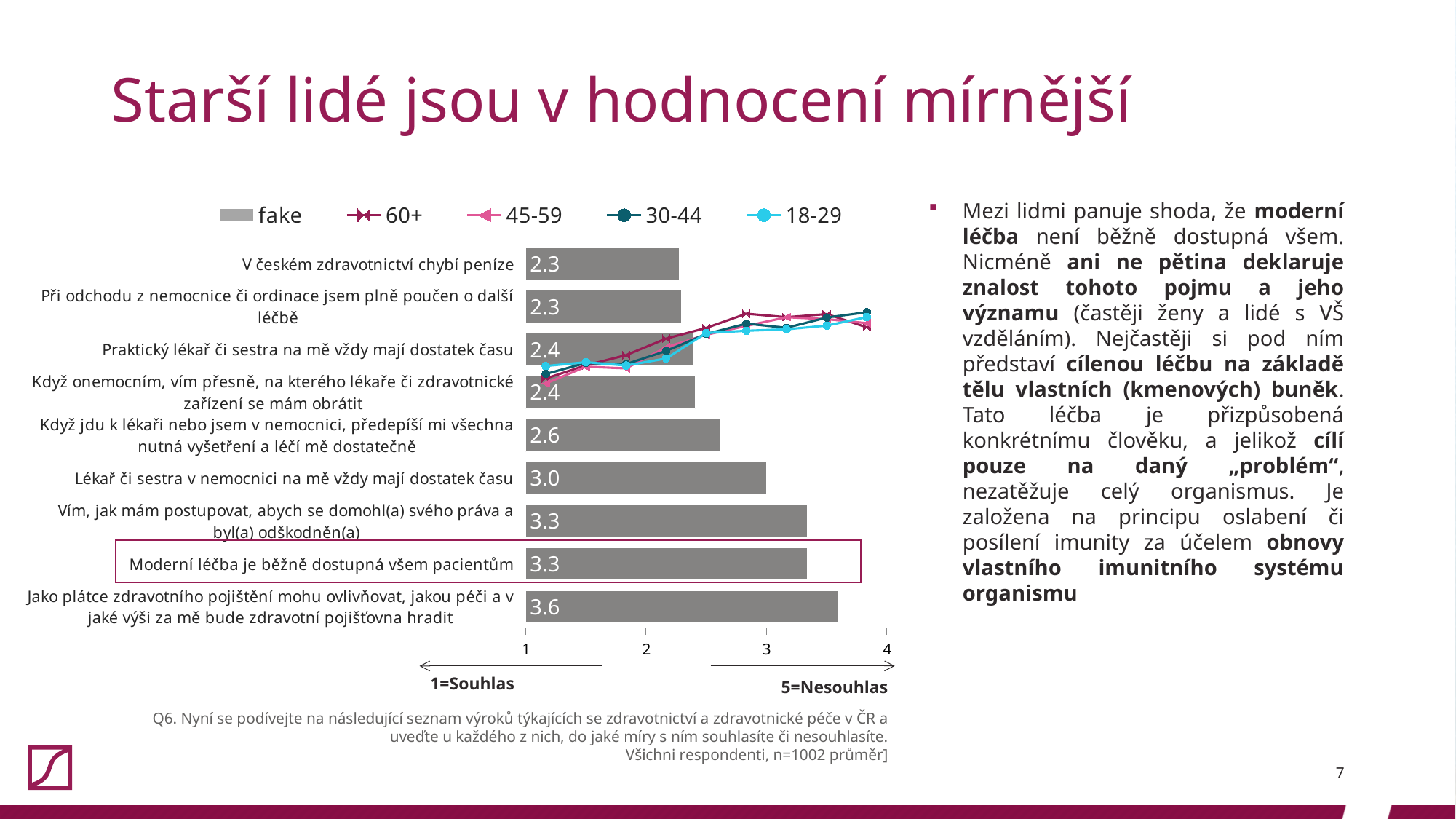
Which has a larger bar value: "Lékař či sestra v nemocnici na mě vždy mají dostatek času" or "Praktický lékař či sestra na mě vždy mají dostatek času"? Lékař či sestra v nemocnici na mě vždy mají dostatek času What is the difference between the bar values for "Jako plátce zdravotního pojištění mohu ovlivňovat, jakou péči a v jaké výši za mě bude zdravotní pojišťovna hradit" and "V českém zdravotnictví chybí peníze"? 1.3 What is the value of the bar for "Moderní léčba je běžně dostupná všem pacientům"? 3.3 How many series does the legend list? 5 What is the value of the bar for "Lékař či sestra v nemocnici na mě vždy mají dostatek času"? 3.0 Which statement is highlighted with a box in the chart? Moderní léčba je běžně dostupná všem pacientům What does the value 1 on the axis represent according to the axis label? Souhlas What kind of chart is used for the grey values on the slide? bar chart What is the value of the bar for "Když jdu k lékaři nebo jsem v nemocnici, předepíší mi všechna nutná vyšetření a léčí mě dostatečně"? 2.6 How many statements (categories) are shown in the chart? 9 Which statement has the highest bar value? Jako plátce zdravotního pojištění mohu ovlivňovat, jakou péči a v jaké výši za mě bude zdravotní pojišťovna hradit What is the value of the bar for "V českém zdravotnictví chybí peníze"? 2.3